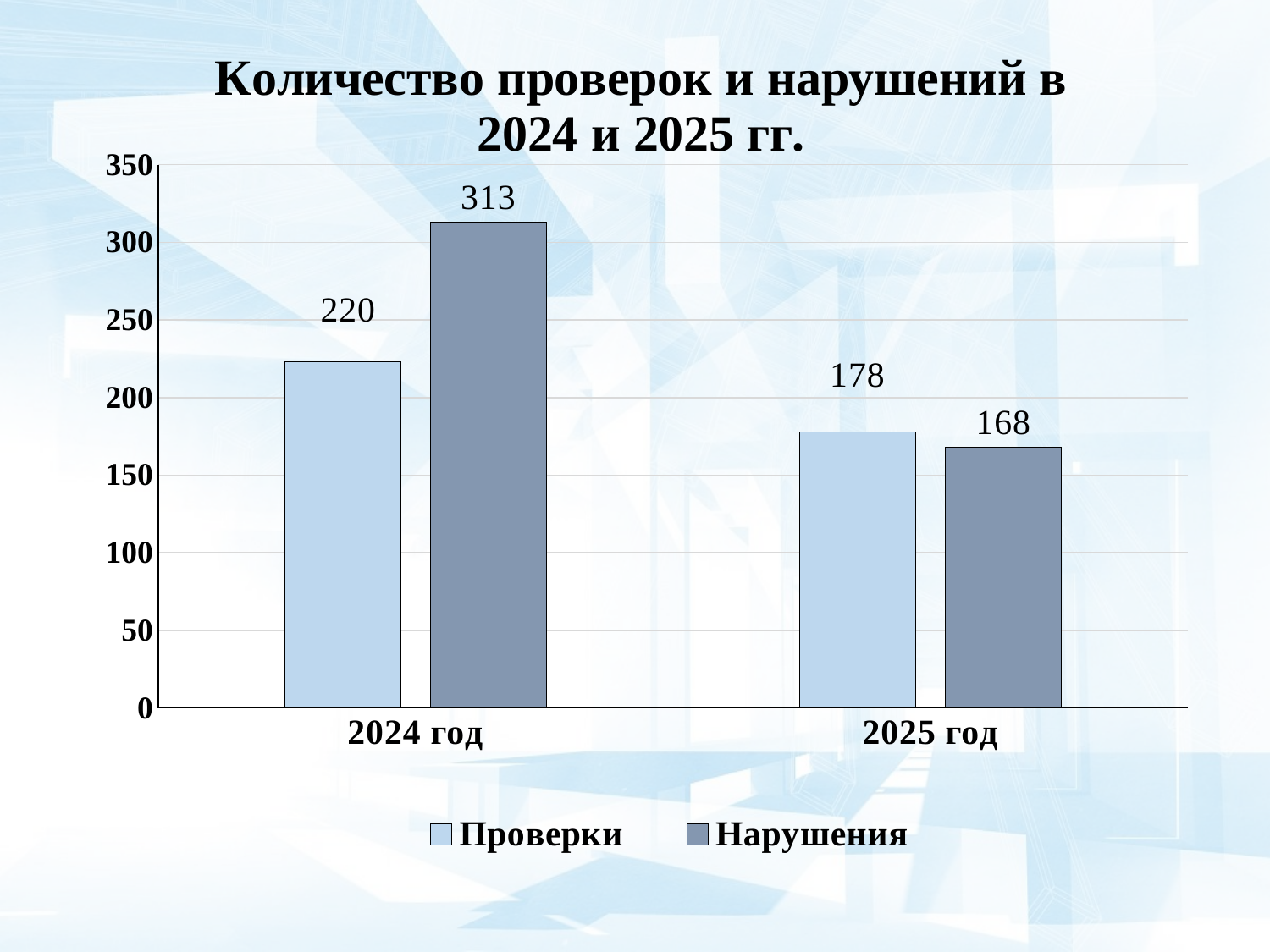
What is the title of the chart? Количество проверок и нарушений в 2024 и 2025 гг. Which is larger for 2025 год: Проверки or Нарушения? Проверки How many categories are shown on the x axis? 2 How many series does the legend list? 2 Which bar has the highest value on the chart? Нарушения, 2024 год Which bar has the lowest value on the chart? Нарушения, 2025 год What kind of chart is shown on the slide? Bar chart What is the value of Проверки for 2024 год? 220 What is the value of Нарушения for 2025 год? 168 What is the value of Проверки for 2025 год? 178 What is the value of Нарушения for 2024 год? 313 What is the difference between Нарушения in 2024 год and Нарушения in 2025 год? 145